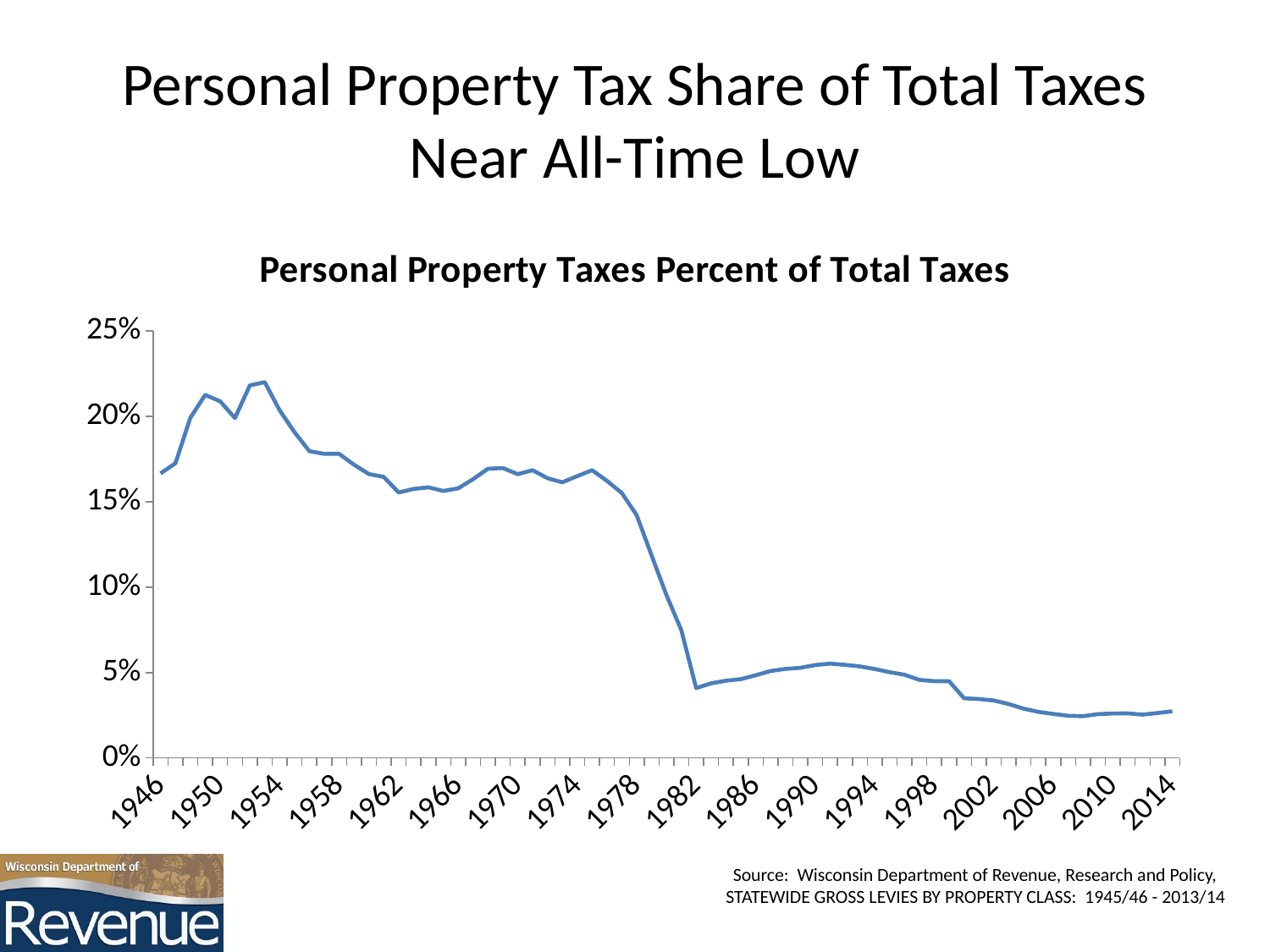
Is the value for 2002 greater or less than 5%? less Is the value for 1986 greater or less than 10%? less Is the value for 1946 greater or less than 15%? greater Which year has the larger value, 1950 or 1990? 1950 What is the highest value shown on the vertical axis? 25% Overall, does the personal property tax share rise or fall from 1946 to 2014? fall What kind of chart is shown on the slide? line chart Which year has the larger value, 1946 or 2014? 1946 What is the title of the chart? Personal Property Taxes Percent of Total Taxes